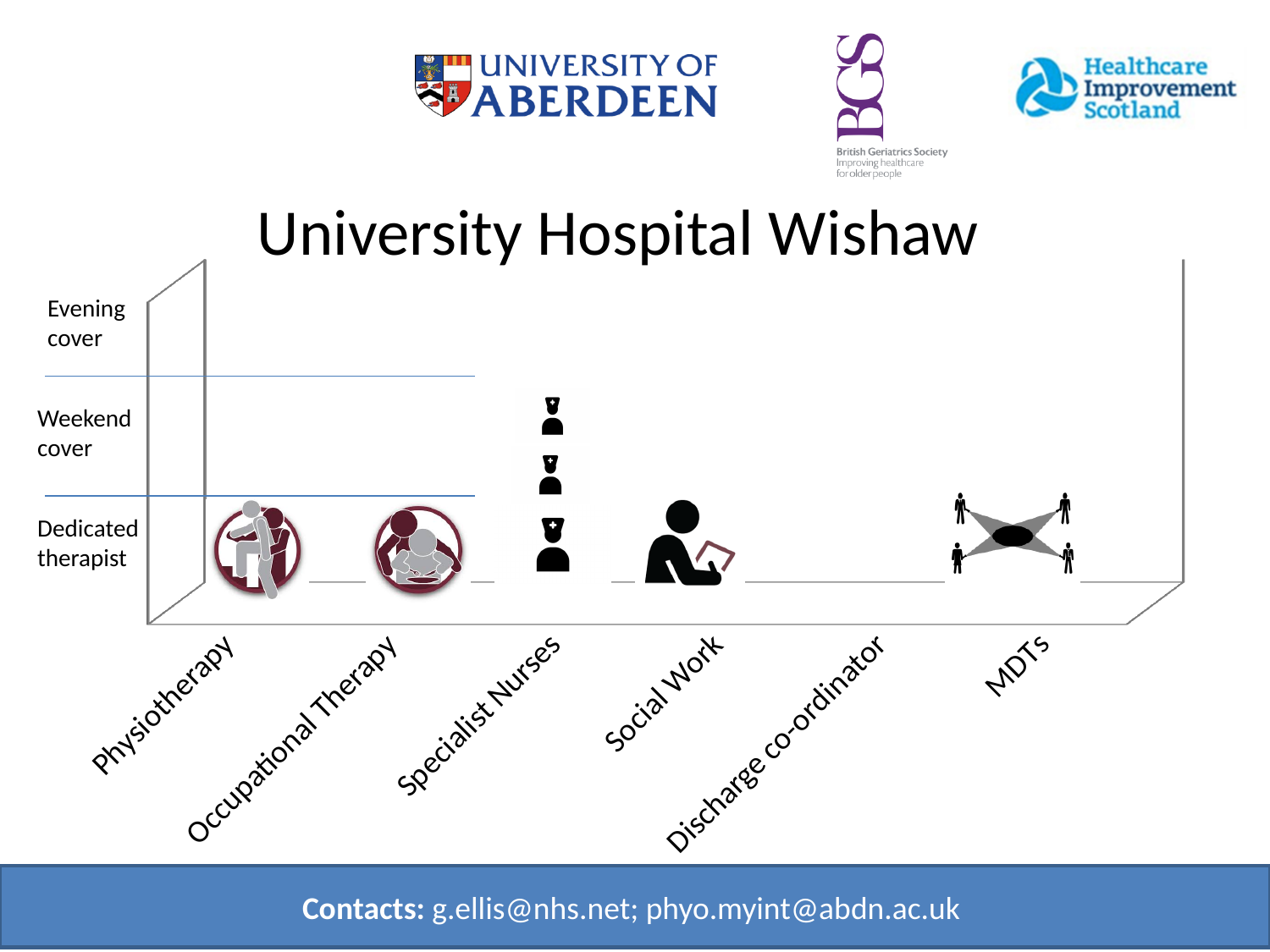
What is the label of the last category on the x axis? MDTs Which category has the tallest stack of icons in the chart? Specialist Nurses Which category has no icon plotted in the chart? Discharge co-ordinator Which cover level does the Specialist Nurses stack reach up to? Weekend cover Which cover level does the Physiotherapy icon sit in? Dedicated therapist Which has a taller stack of icons, Specialist Nurses or Social Work? Specialist Nurses How many levels of cover are labelled on the y axis of the chart? 3 What is the title of the chart? University Hospital Wishaw How many categories are shown along the x axis of the chart? 6 What is the label of the lowest band on the y axis? Dedicated therapist Does any category reach the Evening cover level? No How many nurse icons are stacked for Specialist Nurses? 3